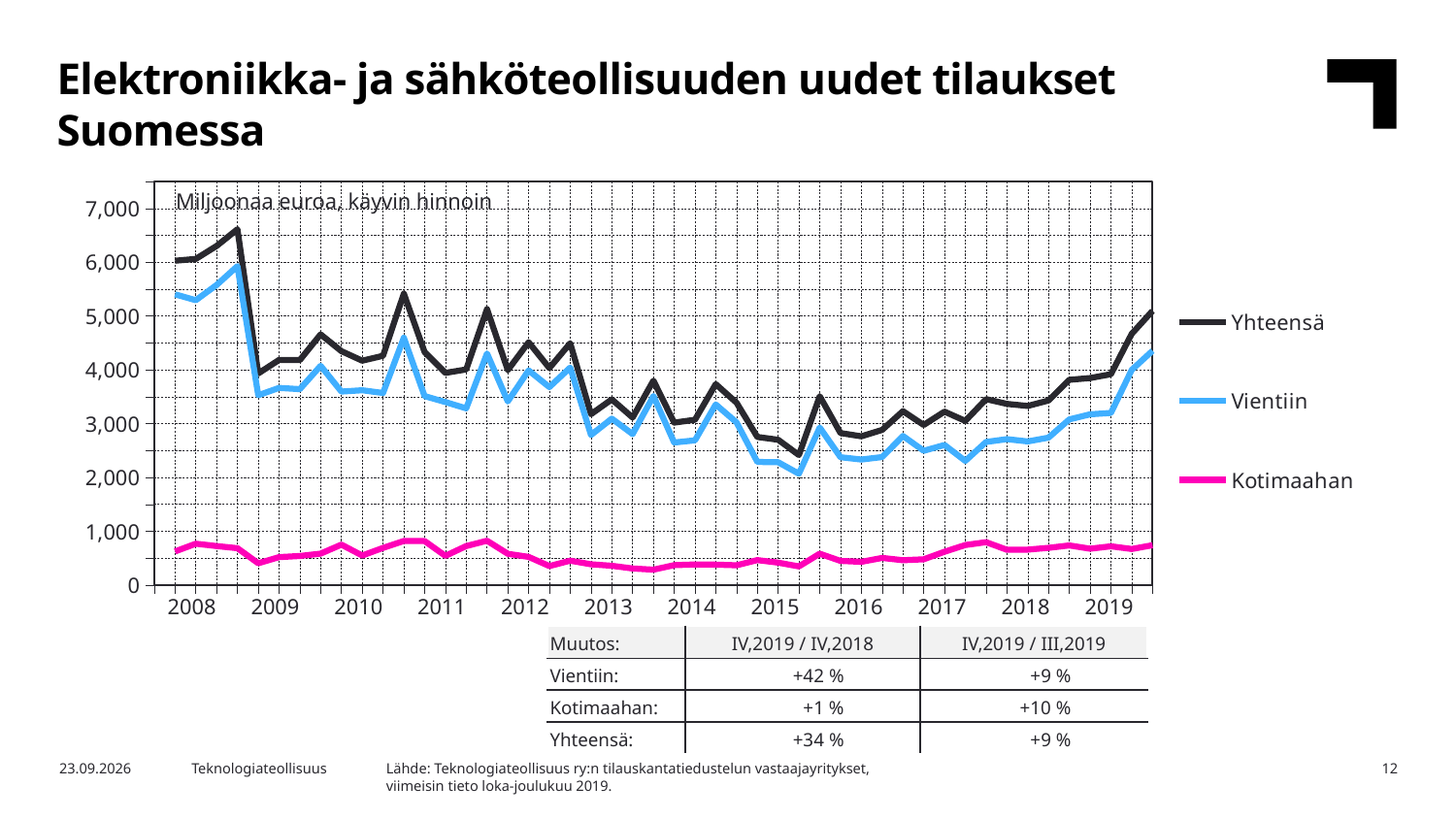
Which series is larger in 2016, Vientiin or Kotimaahan? Vientiin Is the peak value for Yhteensä in 2008 greater or less than 6,000? greater Is the value for Kotimaahan in 2019 greater or less than 1,000? less What unit does the chart's subtitle say the values are in? Miljoonaa euroa, käyvin hinnoin Does the Yhteensä line rise or fall from 2017 to the end of 2019? rise What kind of chart is shown on the slide? line chart Which series is plotted with the pink line? Kotimaahan How many years are labelled on the x axis? 12 Which series has the highest values throughout the chart? Yhteensä How many series does the chart legend list? 3 Is the last value for Vientiin in 2019 greater or less than 4,000? greater Which series has the lowest values throughout the chart? Kotimaahan